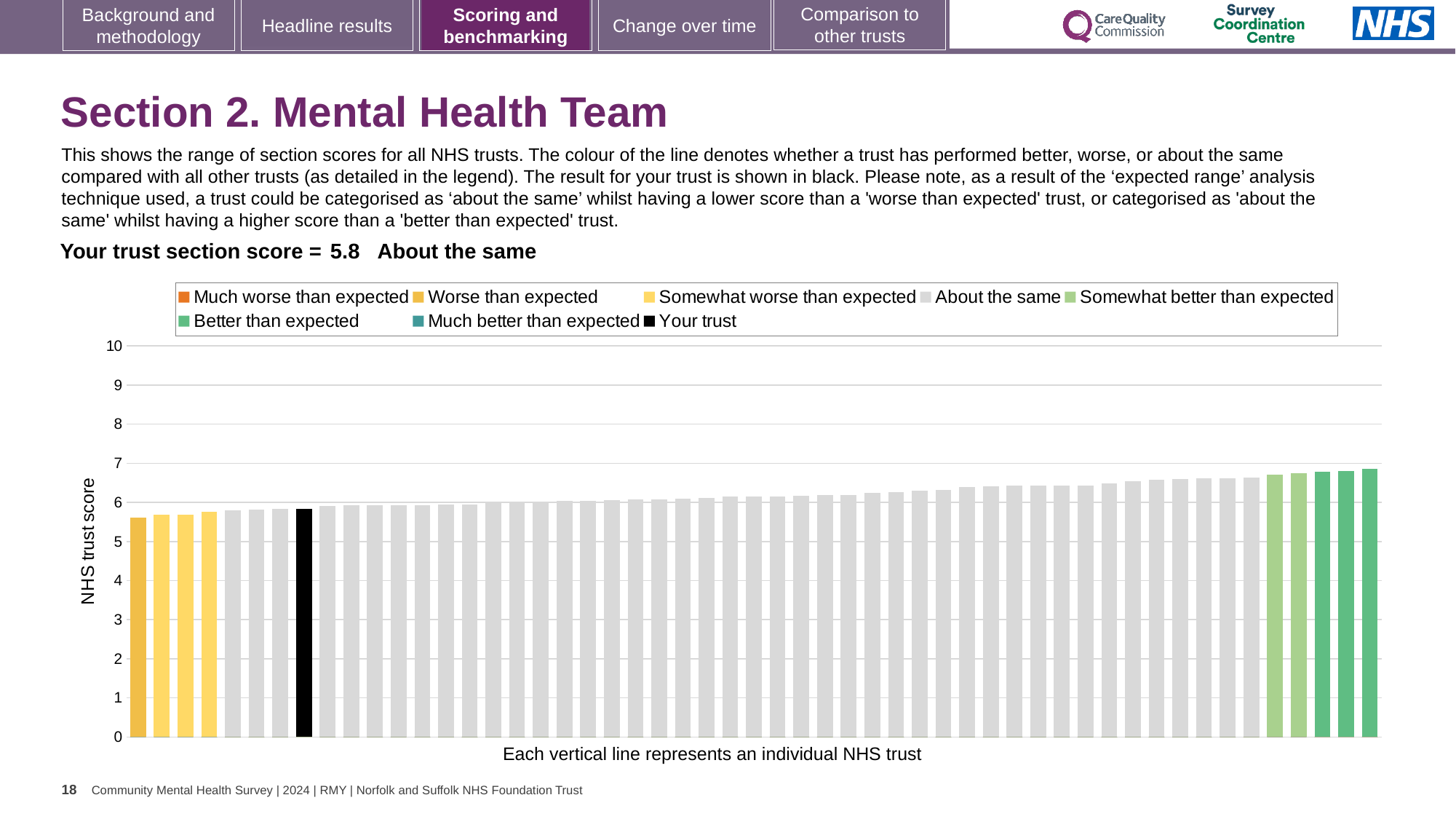
What is the section score for your trust shown on the slide? 5.8 Which category is your trust placed in for this section? About the same How many bars are coloured dark green (Better than expected)? 3 Do the bar values rise or fall from left to right along the x axis? rise Is the value of the shortest bar greater or less than 5? greater What kind of chart is shown on the slide? bar chart Is the value of the tallest bar greater or less than 7? less What is the label on the vertical axis of the chart? NHS trust score Is the value of the black bar (your trust) greater or less than 6? less How many entries does the chart legend list? 8 Which is larger, the leftmost bar or the rightmost bar? the rightmost bar